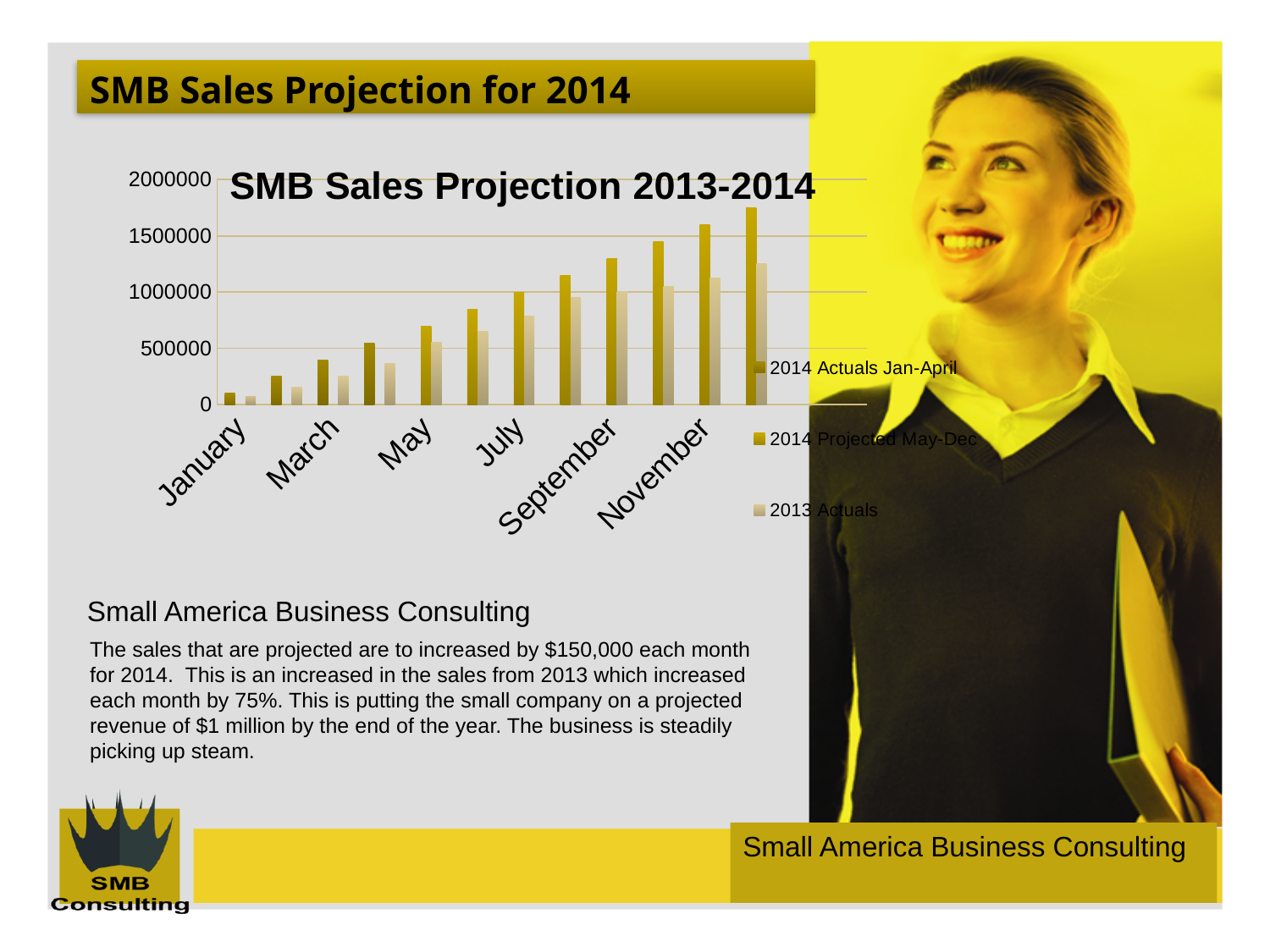
Which legend entry is listed first in the chart legend? 2014 Actuals Jan-April Which month has the shortest bars on the chart? January Is the 2014 Actuals Jan-April value for January greater or less than 500000? less Which month has the tallest bar on the chart? December How many series does the chart legend list? 3 Is the 2014 Projected May-Dec value for December greater or less than 1500000? greater How many months (bar groups) are plotted on the chart? 12 What type of chart is shown on the slide? bar chart Do the sales values rise or fall from January to December? rise Is the 2013 Actuals value for December greater or less than 1000000? greater For December, which is larger: the 2014 Projected May-Dec value or the 2013 Actuals value? 2014 Projected May-Dec What is the title of the chart? SMB Sales Projection 2013-2014